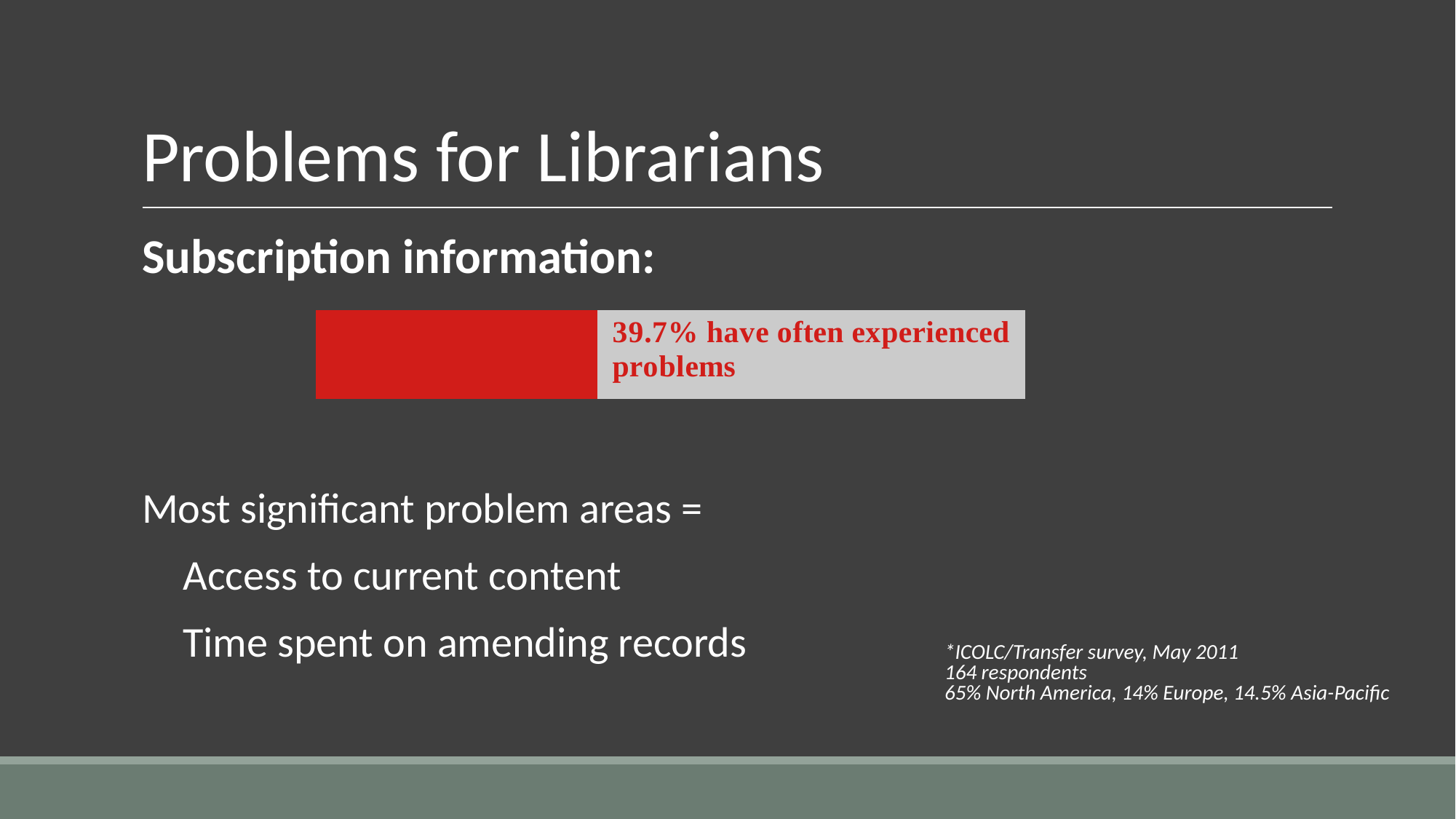
What percentage of respondents have often experienced problems with subscription information, according to the bar? 39.7% What colour is the filled portion of the bar representing those who have often experienced problems? red What does the red portion of the bar represent? 39.7% have often experienced problems Is the value shown by the red portion of the bar greater or less than 50%? less How many bars are shown in the chart? 1 What kind of chart is used to show the share of respondents who have often experienced problems? bar chart